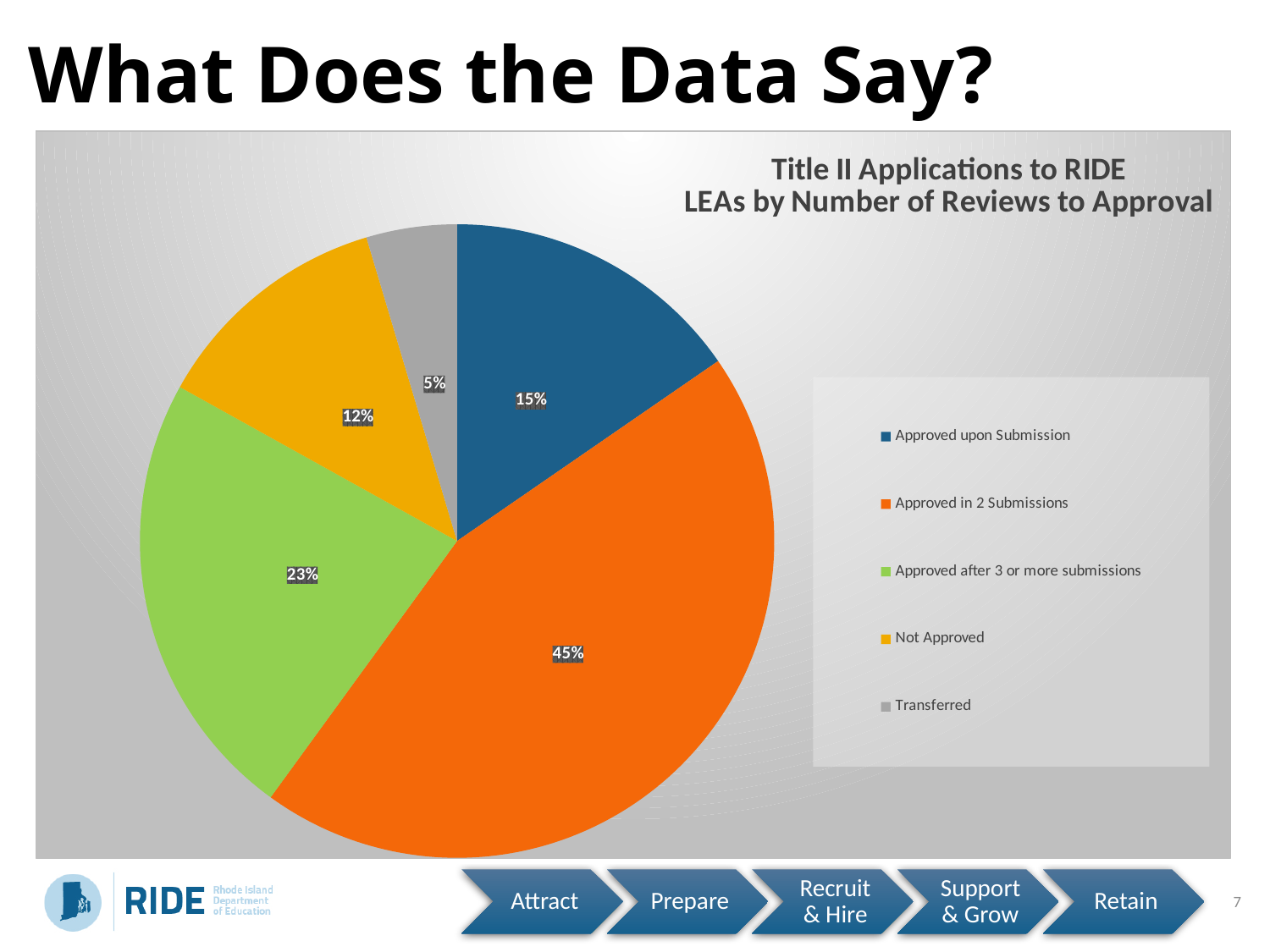
What is the difference in percentage points between Approved in 2 Submissions and Approved after 3 or more submissions? 22 What share of LEAs were Transferred? 5% What share of LEAs were Approved after 3 or more submissions? 23% What share of LEAs were Not Approved? 12% How many categories does the legend list? 5 What is the title of the chart? Title II Applications to RIDE LEAs by Number of Reviews to Approval Which is larger: the share for Approved upon Submission or the share for Not Approved? Approved upon Submission What type of chart is shown on the slide? pie chart Which category has the smallest slice of the pie? Transferred Which category has the largest slice of the pie? Approved in 2 Submissions